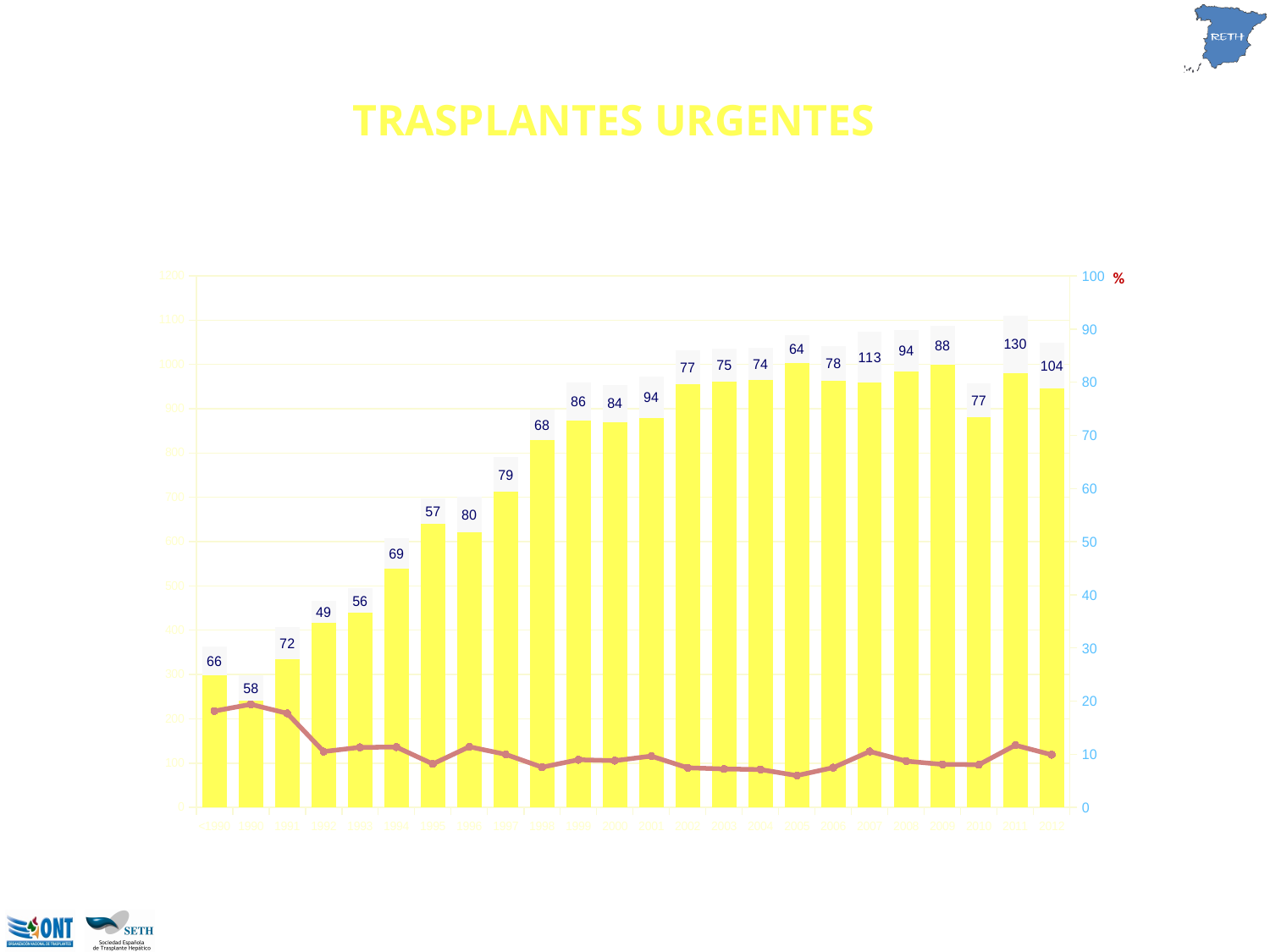
What is the difference between the data labels of the second-to-last bar (130) and the last bar (104)? 26 What is the lowest data label printed above the bars? 49 What is the data label on the first (leftmost) bar? 66 Which has the larger data label, the first bar or the second bar? the first bar What is the data label on the last (rightmost) bar? 104 What kind of chart is shown on the slide? bar chart with a line overlay On the right-hand percentage axis, is the value of the line at the last point greater or less than 20? less Do the bar heights generally rise or fall from left to right across the chart? rise What colour are the bars in the chart? yellow What is the highest data label printed above the bars? 130 What is the title of the chart? TRASPLANTES URGENTES How many bars are plotted in the chart? 24